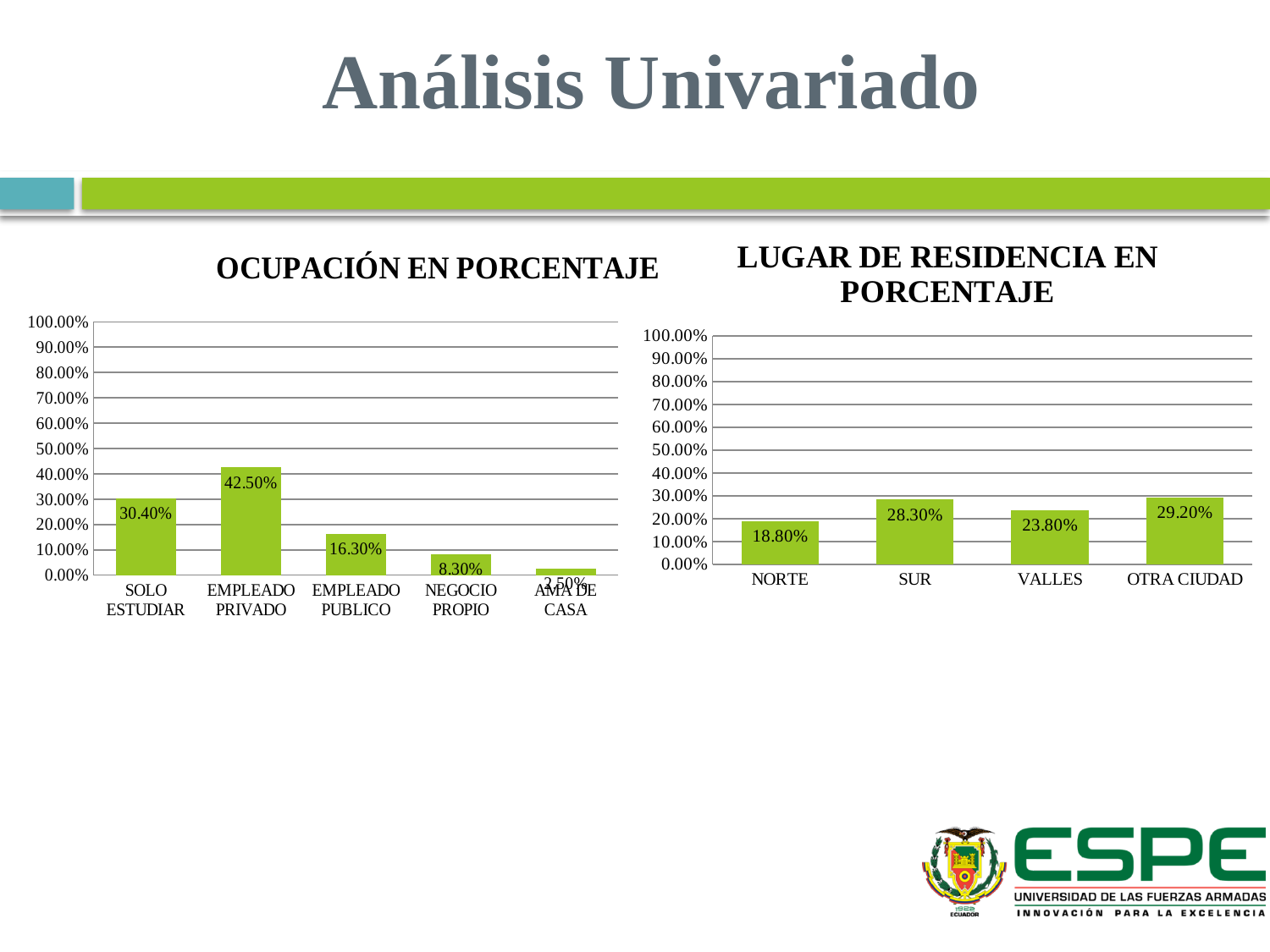
In the OCUPACIÓN EN PORCENTAJE chart, which category has the lowest value? AMA DE CASA In the OCUPACIÓN EN PORCENTAJE chart, what is the value for SOLO ESTUDIAR? 30.40% In the LUGAR DE RESIDENCIA EN PORCENTAJE chart, which is larger, SUR or VALLES? SUR In the OCUPACIÓN EN PORCENTAJE chart, how many categories are shown? 5 In the LUGAR DE RESIDENCIA EN PORCENTAJE chart, what is the value for NORTE? 18.80% In the LUGAR DE RESIDENCIA EN PORCENTAJE chart, what is the value for VALLES? 23.80% What type of chart is the LUGAR DE RESIDENCIA EN PORCENTAJE chart? Bar chart In the OCUPACIÓN EN PORCENTAJE chart, which category has the highest value? EMPLEADO PRIVADO In the OCUPACIÓN EN PORCENTAJE chart, what is the difference between EMPLEADO PRIVADO and EMPLEADO PUBLICO? 26.20% In the LUGAR DE RESIDENCIA EN PORCENTAJE chart, what is the difference between OTRA CIUDAD and NORTE? 10.40% In the OCUPACIÓN EN PORCENTAJE chart, what is the value for EMPLEADO PRIVADO? 42.50% In the LUGAR DE RESIDENCIA EN PORCENTAJE chart, which category has the highest value? OTRA CIUDAD